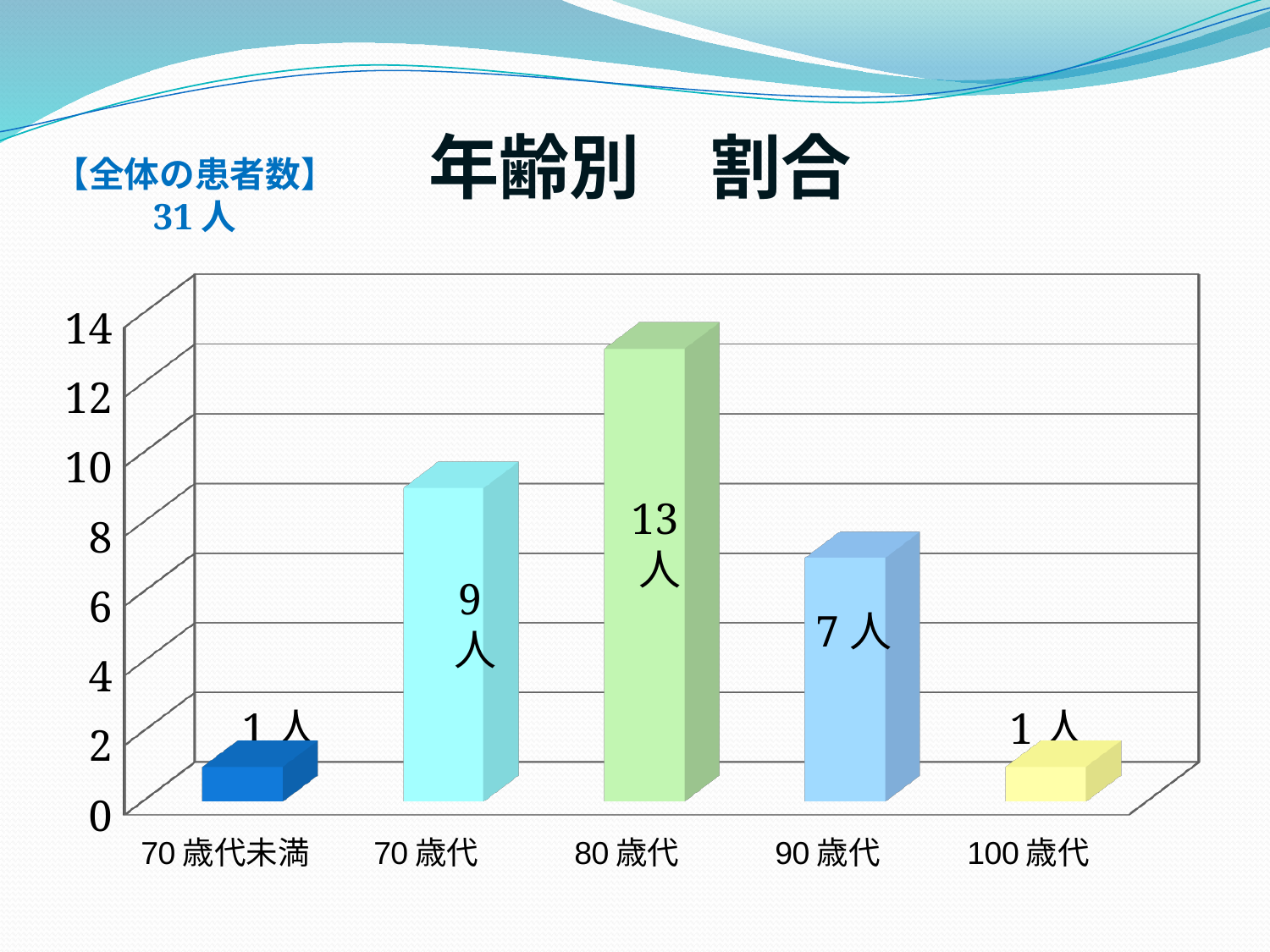
Is the value for 80歳代 greater or less than 12? greater What is the difference between the values for 80歳代 and 70歳代? 4人 What kind of chart is shown on the slide? bar chart How many age categories are shown on the x axis? 5 What is the title of the chart? 年齢別 割合 What is the value for 100歳代? 1人 What is the value for 80歳代? 13人 What is the value for 70歳代? 9人 Which is larger, the value for 70歳代 or the value for 90歳代? 70歳代 What is the value for 90歳代? 7人 What is the difference between the values for 90歳代 and 70歳代未満? 6人 Which age category has the highest value? 80歳代